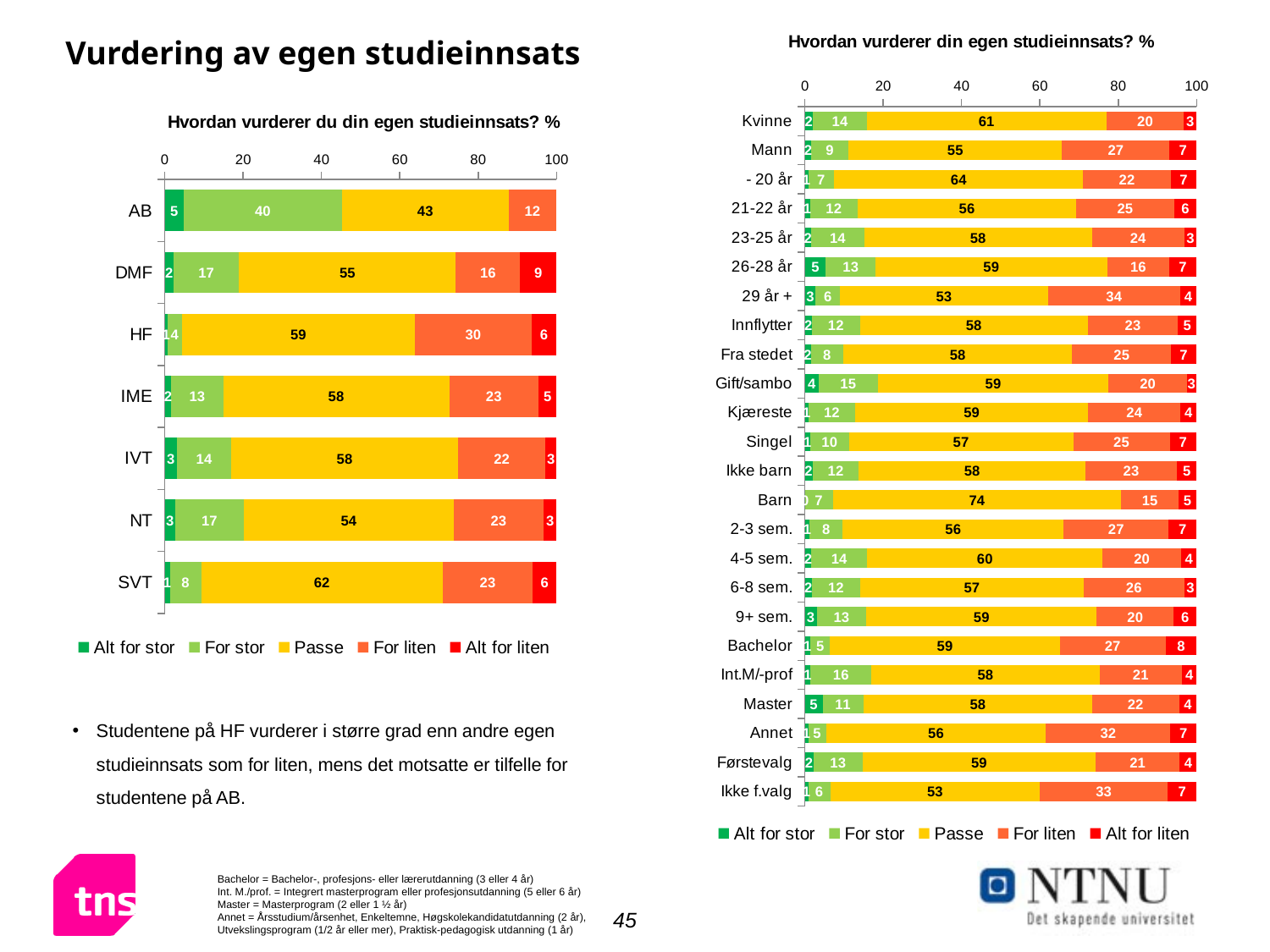
In the left chart 'Hvordan vurderer du din egen studieinnsats? %', what is the difference between the 'Passe' values for SVT and NT? 8 In the left chart 'Hvordan vurderer du din egen studieinnsats? %', what is the 'For liten' value for HF? 30 In the left chart 'Hvordan vurderer du din egen studieinnsats? %', how many faculties are shown? 7 In the right chart 'Hvordan vurderer din egen studieinnsats? %', what is the 'Passe' value for Barn? 74 In the right chart 'Hvordan vurderer din egen studieinnsats? %', what is the difference between the 'Passe' values for Førstevalg and Ikke f.valg? 6 In the left chart 'Hvordan vurderer du din egen studieinnsats? %', what is the 'Passe' value for SVT? 62 In the left chart 'Hvordan vurderer du din egen studieinnsats? %', how many series does the legend list? 5 In the right chart 'Hvordan vurderer din egen studieinnsats? %', which is larger, the 'For liten' value for Kvinne or for Mann? Mann In the right chart 'Hvordan vurderer din egen studieinnsats? %', what is the 'For liten' value for 29 år +? 34 In the left chart 'Hvordan vurderer du din egen studieinnsats? %', which faculty has the highest 'For stor' value? AB What type of chart is the right chart 'Hvordan vurderer din egen studieinnsats? %'? Stacked bar chart In the left chart 'Hvordan vurderer du din egen studieinnsats? %', which faculty has the lowest 'Passe' value? AB